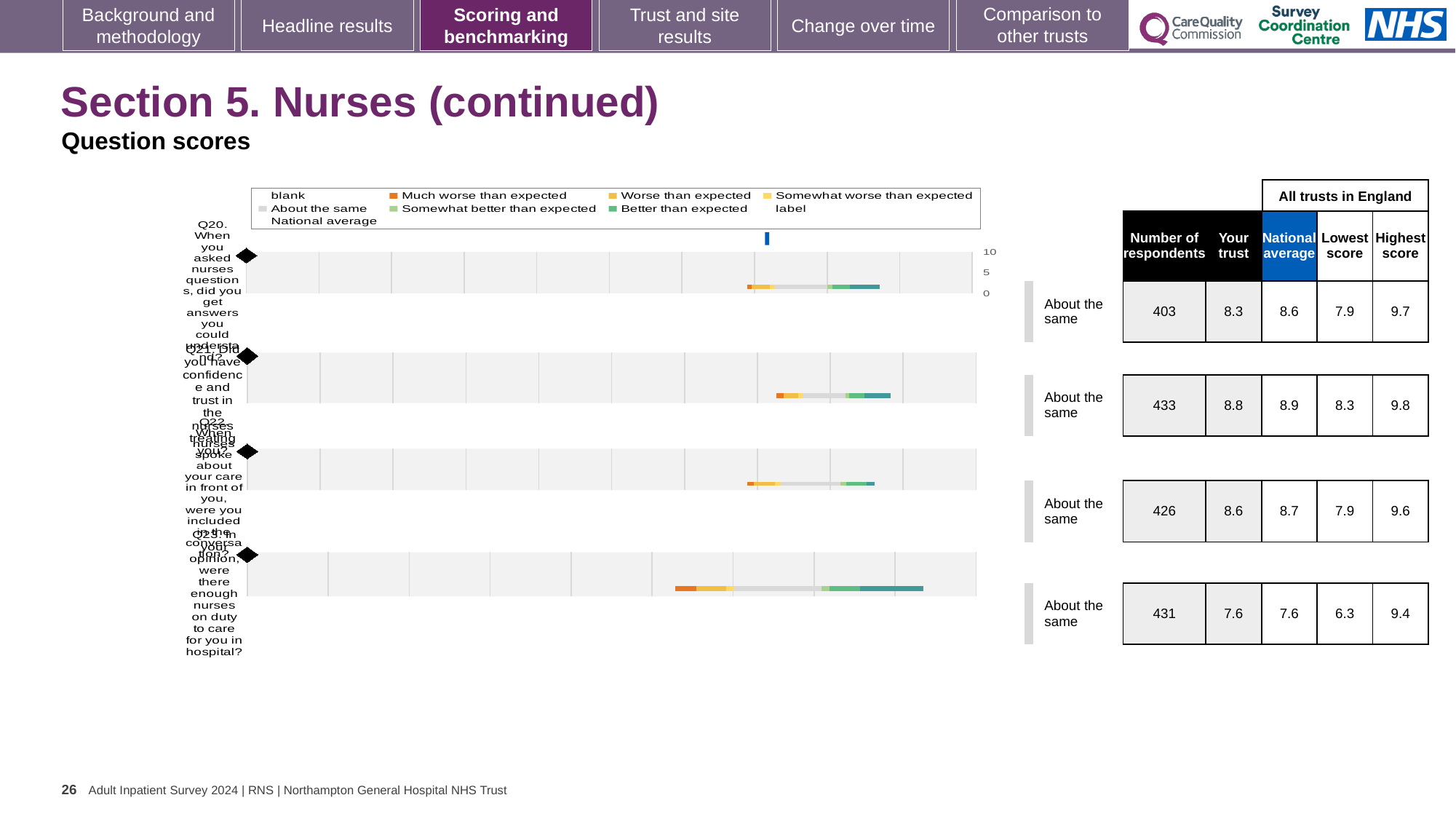
What is the highest tick value shown on the chart's score axis? 10 How many entries does the chart legend list? 9 In the table beside the chart, what is the difference between the highest score and the lowest score for Q22? 1.7 What kind of chart is shown on the slide? bar chart In the table beside the chart, which question has the lowest 'Lowest score' value? Q23 How many question categories (Q20 to Q23) are plotted in the chart? 4 In the table beside the chart, what is the 'Your trust' score for Q20? 8.3 In the table beside the chart, what is the national average for Q23? 7.6 In the table beside the chart, which question has the highest 'Your trust' score? Q21 In the table beside the chart, is the 'Your trust' score for Q20 larger or smaller than the national average for Q20? smaller In the table beside the chart, what is the number of respondents for Q21? 433 What benchmark label is shown next to the chart for Q23? About the same